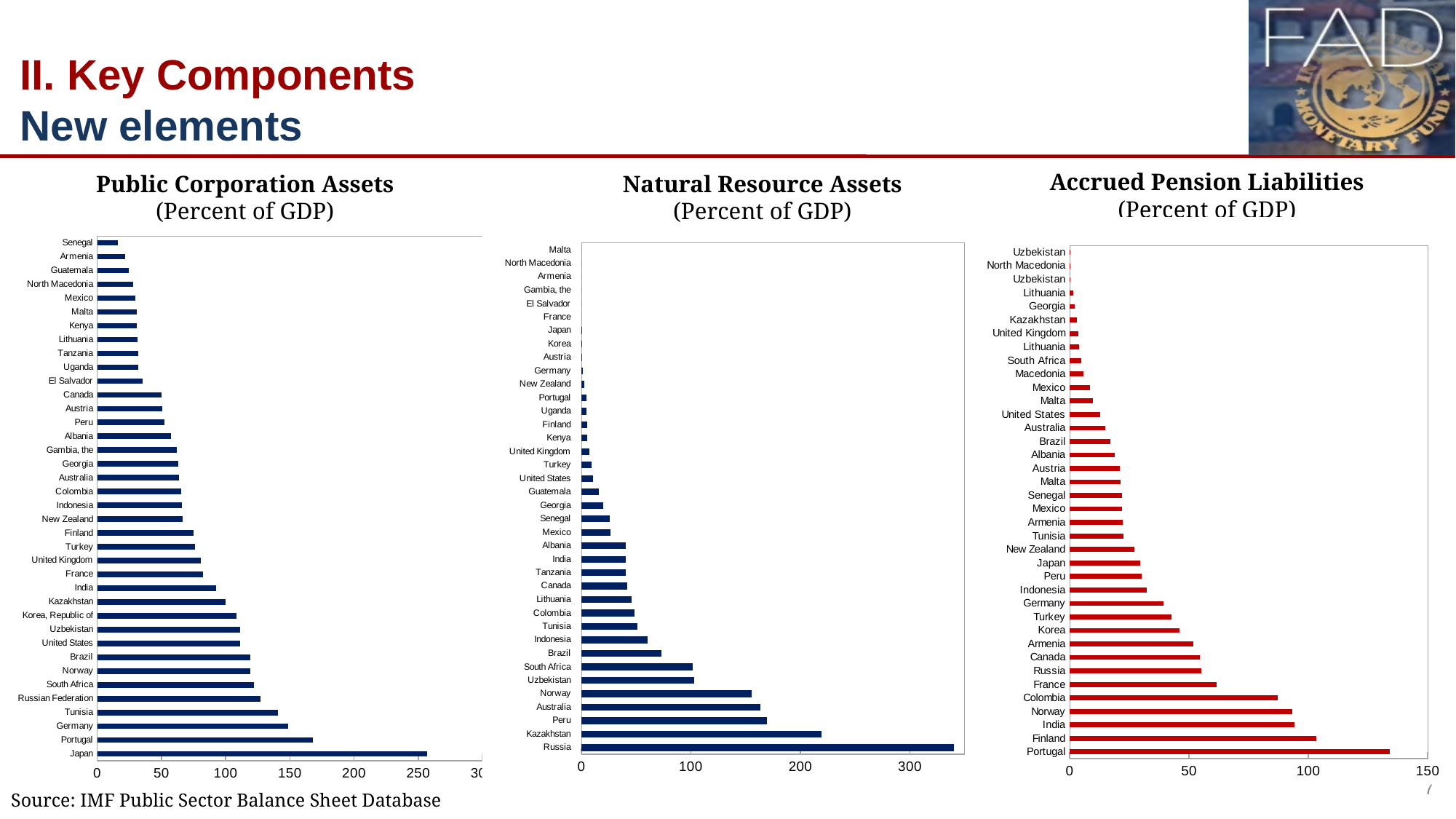
In the Public Corporation Assets chart, is the value for India greater or less than 100? less In the Accrued Pension Liabilities chart, which country has the highest value? Portugal In the Natural Resource Assets chart, is the value for Kazakhstan greater or less than 200? greater In the Natural Resource Assets chart, which country has the highest value? Russia In the Public Corporation Assets chart, is the value for Japan greater or less than 250? greater What kind of chart is the Accrued Pension Liabilities chart? Bar chart In the Public Corporation Assets chart, which country has the lowest value? Senegal In the Natural Resource Assets chart, which is larger, the value for Russia or the value for Kazakhstan? Russia What source is cited for the charts on the slide? IMF Public Sector Balance Sheet Database In the Public Corporation Assets chart, which country has the highest value? Japan